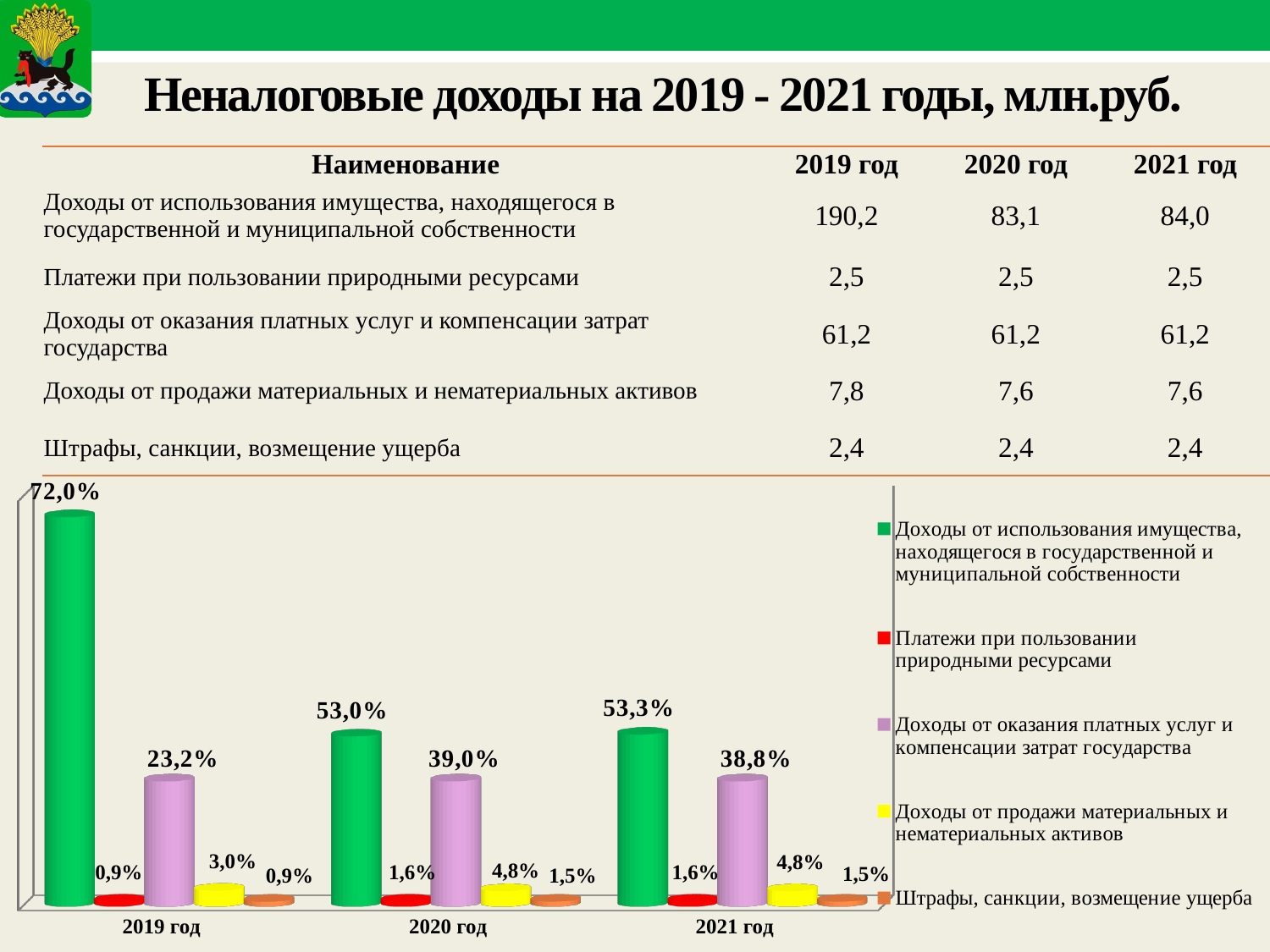
What is the value for 'Доходы от оказания платных услуг и компенсации затрат государства' in 2020 год on the chart? 39,0% Does the value for 'Доходы от использования имущества, находящегося в государственной и муниципальной собственности' rise or fall from 2019 год to 2020 год on the chart? fall How many year categories are shown on the chart's x axis? 3 How many series does the chart legend list? 5 What is the value for 'Доходы от использования имущества, находящегося в государственной и муниципальной собственности' in 2019 год on the chart? 72,0% Which is larger on the chart: 'Доходы от оказания платных услуг и компенсации затрат государства' in 2020 год or in 2021 год? 2020 год What is the value for 'Штрафы, санкции, возмещение ущерба' in 2019 год on the chart? 0,9% What is the difference between the 2019 год and 2020 год values for 'Доходы от использования имущества, находящегося в государственной и муниципальной собственности' on the chart? 19,0% What kind of chart is shown at the bottom of the slide? bar chart Which year has the lowest value for 'Доходы от оказания платных услуг и компенсации затрат государства' on the chart? 2019 год What is the value for 'Доходы от продажи материальных и нематериальных активов' in 2021 год on the chart? 4,8% Which year has the highest value for 'Доходы от использования имущества, находящегося в государственной и муниципальной собственности' on the chart? 2019 год